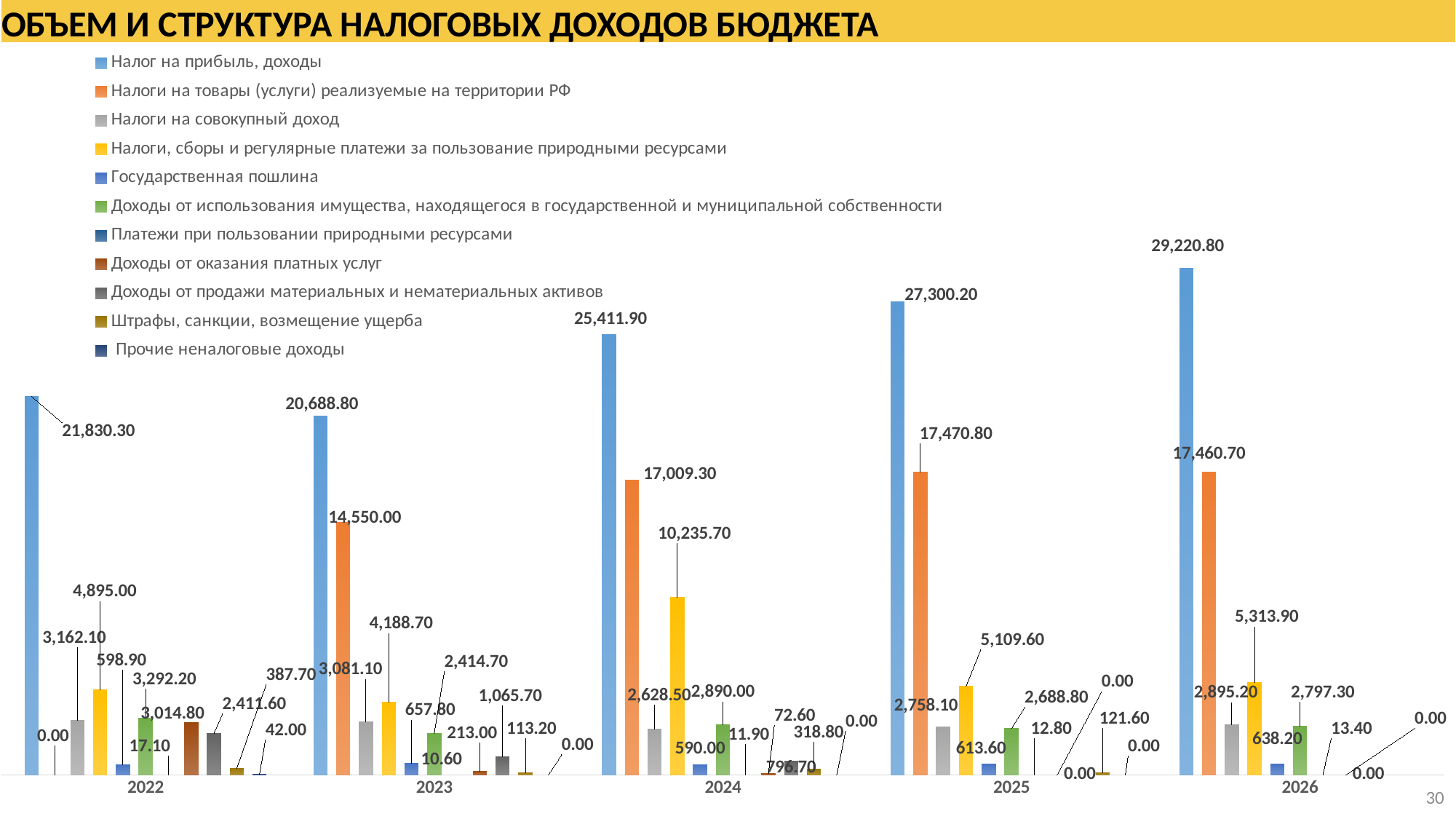
In which year is «Налог на прибыль, доходы» the highest? 2026 How many series does the legend list? 11 What is the value of «Налог на прибыль, доходы» for 2026? 29,220.80 Does «Налог на прибыль, доходы» rise or fall from 2023 to 2026? Rises What kind of chart is shown on the slide? Bar chart In which year is «Налог на прибыль, доходы» the lowest? 2023 What is the value of «Налоги, сборы и регулярные платежи за пользование природными ресурсами» for 2024? 10,235.70 How many years are shown on the x axis? 5 What is the difference between «Налог на прибыль, доходы» in 2026 and in 2025? 1,920.60 Which year has the larger value for «Налоги, сборы и регулярные платежи за пользование природными ресурсами», 2024 or 2025? 2024 What is the value of «Налоги на товары (услуги) реализуемые на территории РФ» for 2023? 14,550.00 What is the value of «Доходы от использования имущества, находящегося в государственной и муниципальной собственности» for 2025? 2,688.80